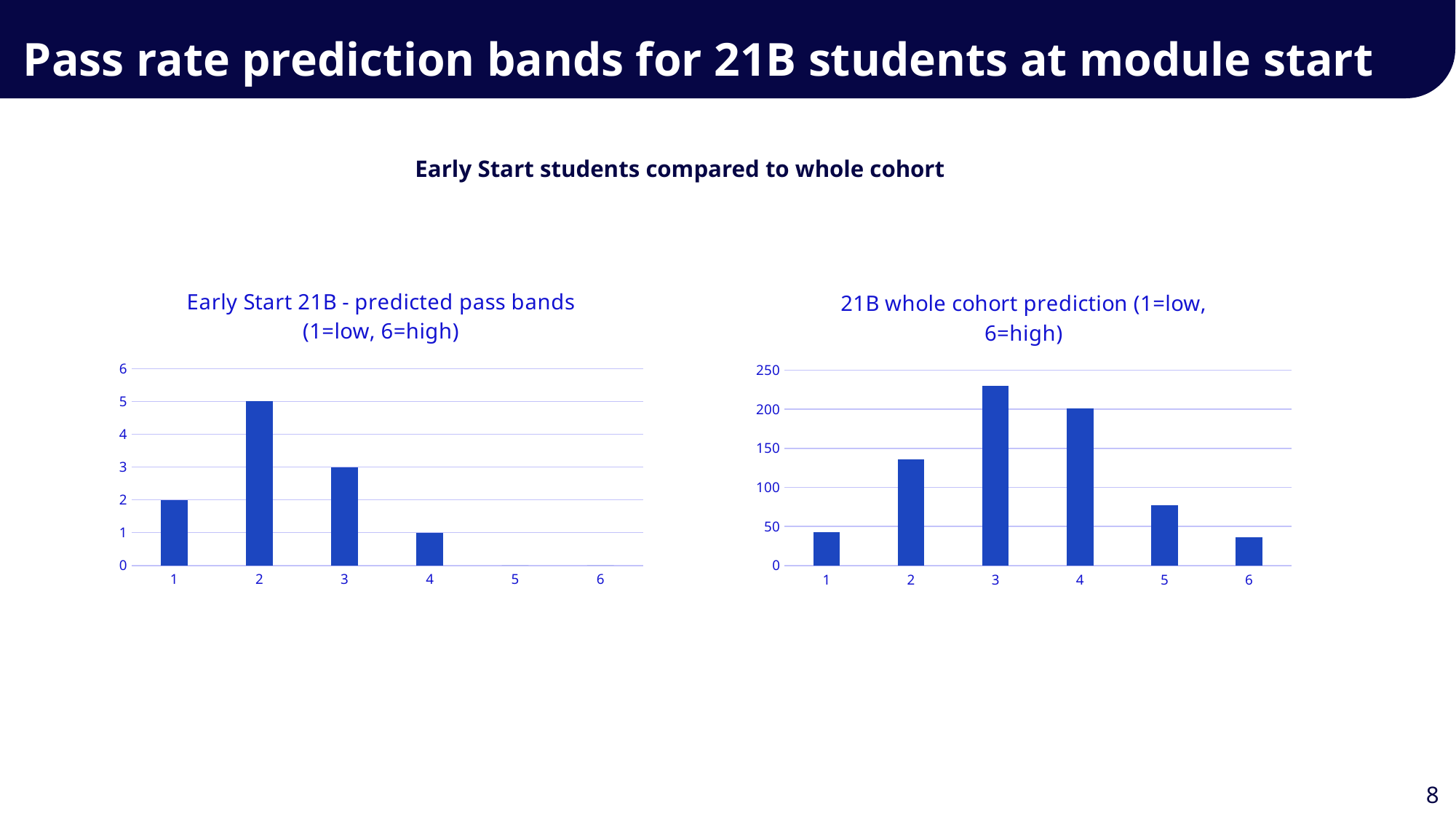
In the '21B whole cohort prediction' chart, is the value for band 3 greater or less than 200? greater What type of chart is the '21B whole cohort prediction' chart? bar chart In the '21B whole cohort prediction' chart, which band has the lowest value? 6 In the '21B whole cohort prediction' chart, which band has the highest value? 3 In the 'Early Start 21B - predicted pass bands' chart, what is the value for band 2? 5 In the 'Early Start 21B - predicted pass bands' chart, what is the value for band 4? 1 In the 'Early Start 21B - predicted pass bands' chart, which band has the highest value? 2 In the 'Early Start 21B - predicted pass bands' chart, what is the value for band 1? 2 In the 'Early Start 21B - predicted pass bands' chart, how many bands are shown on the x axis? 6 In the '21B whole cohort prediction' chart, is the value for band 1 greater or less than 50? less In the 'Early Start 21B - predicted pass bands' chart, what is the difference between the values for band 2 and band 3? 2 In the '21B whole cohort prediction' chart, which is larger, the value for band 2 or the value for band 5? band 2